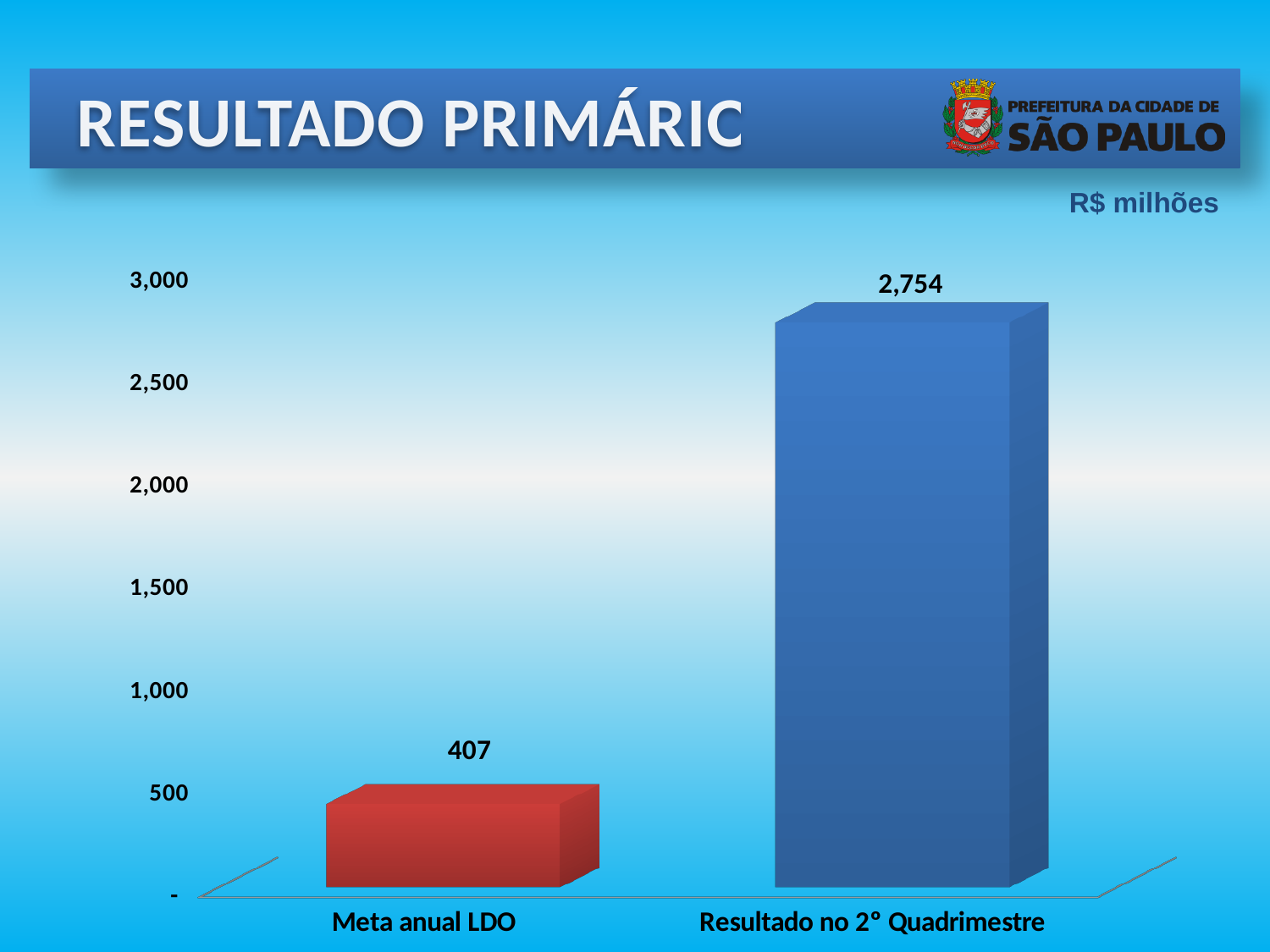
How many categories are shown in the chart? 2 What is the value for Resultado no 2º Quadrimestre? 2,754 Is the value for Resultado no 2º Quadrimestre greater or less than 2,500? greater What kind of chart is shown on the slide? bar chart Which is larger, the value for Meta anual LDO or the value for Resultado no 2º Quadrimestre? Resultado no 2º Quadrimestre Is the value for Meta anual LDO greater or less than 500? less Which category has the lowest value? Meta anual LDO What colour is the bar for Meta anual LDO? red What is the difference between the values for Resultado no 2º Quadrimestre and Meta anual LDO? 2,347 What is the value for Meta anual LDO? 407 What unit is indicated for the values in the chart? R$ milhões Which category has the highest value? Resultado no 2º Quadrimestre